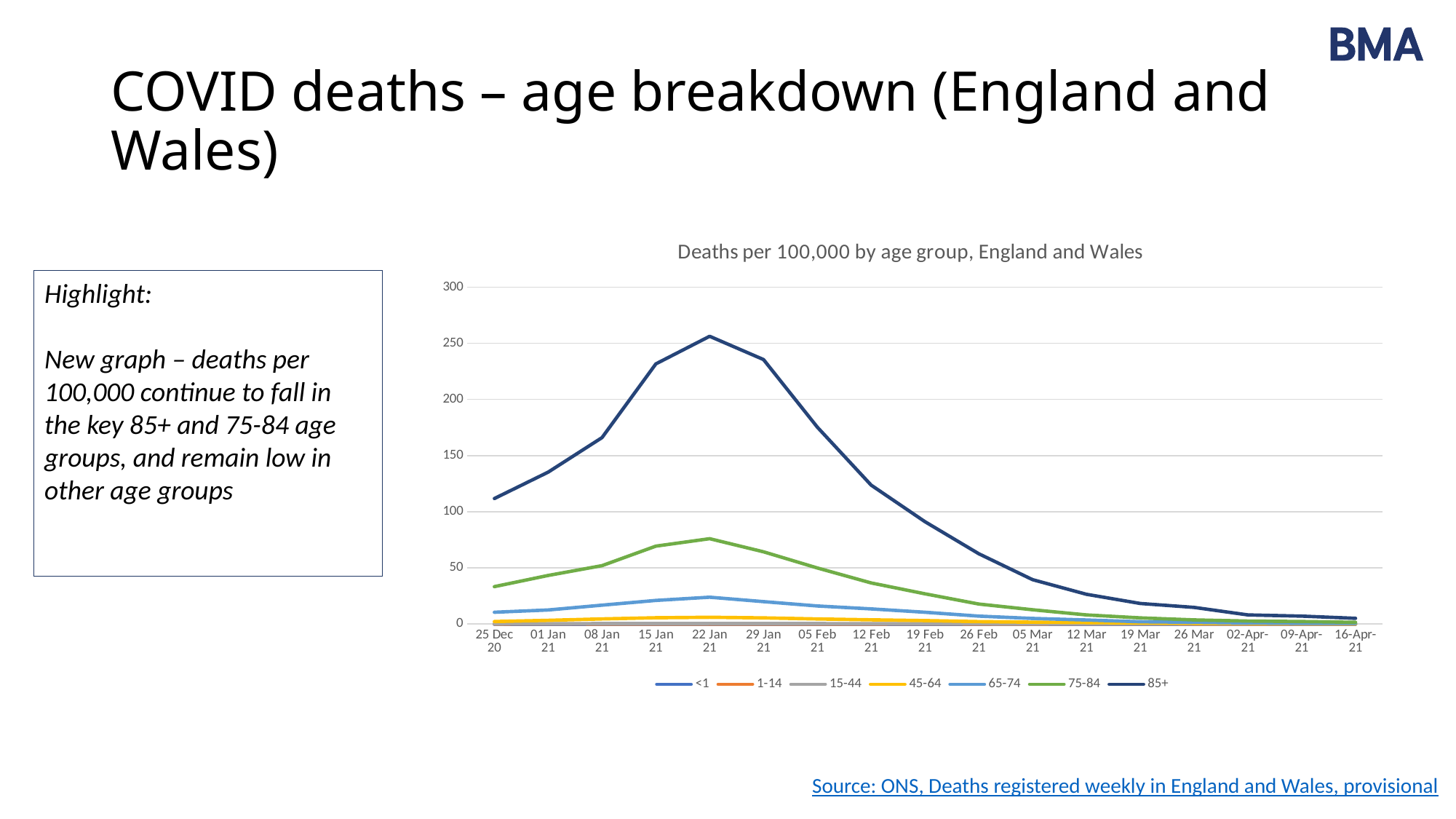
Is the value for the 85+ group on 25 Dec 20 greater or less than 100? greater Does the 85+ series rise or fall between 22 Jan 21 and 16-Apr-21? fall Is the value for the 85+ group on 22 Jan 21 greater or less than 250? greater What is the title of the chart? Deaths per 100,000 by age group, England and Wales What kind of chart is shown on the slide? line chart Is the value for the 75-84 group on 22 Jan 21 greater or less than 50? greater How many dates are shown along the x axis? 17 How many age-group series does the legend list? 7 On which date does the 85+ series reach its peak? 22 Jan 21 Which age group has the highest deaths per 100,000 throughout the chart? 85+ On 22 Jan 21, which is larger: the value for 85+ or the value for 75-84? 85+